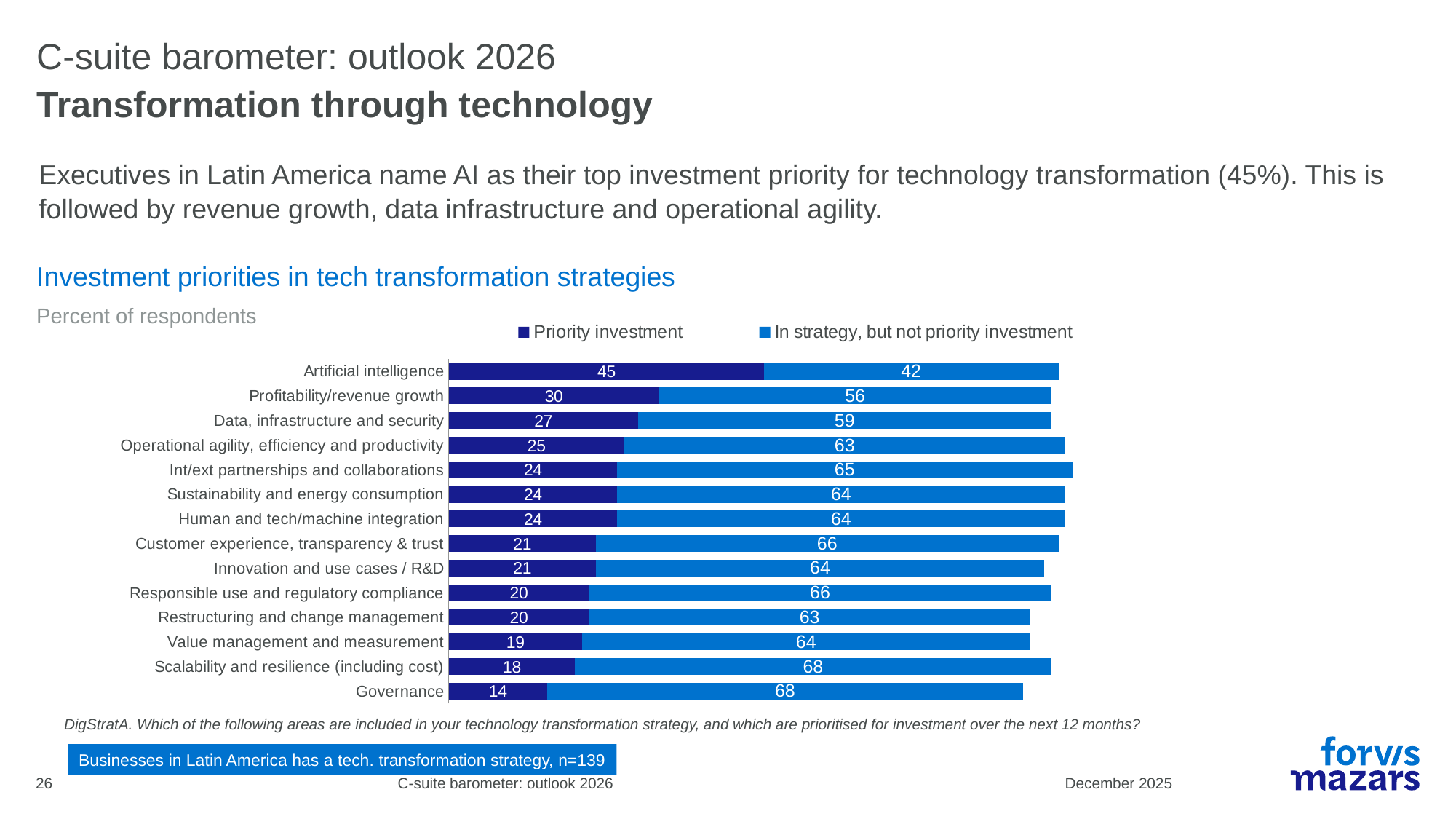
What percentage of respondents name Artificial intelligence as a priority investment? 45 What is the 'In strategy, but not priority investment' value for Governance? 68 How many series does the legend list? 2 What is the difference between the 'Priority investment' values for Artificial intelligence and Profitability/revenue growth? 15 Which has a larger 'Priority investment' value: Data, infrastructure and security or Operational agility, efficiency and productivity? Data, infrastructure and security How many categories are shown in the chart? 14 What type of chart is shown on the slide? Stacked bar chart What is the 'Priority investment' value for Scalability and resilience (including cost)? 18 What is the total of the stacked bar for Int/ext partnerships and collaborations? 89 Which category has the lowest 'Priority investment' value? Governance Which category has the highest 'Priority investment' value? Artificial intelligence Which category has the lowest 'In strategy, but not priority investment' value? Artificial intelligence